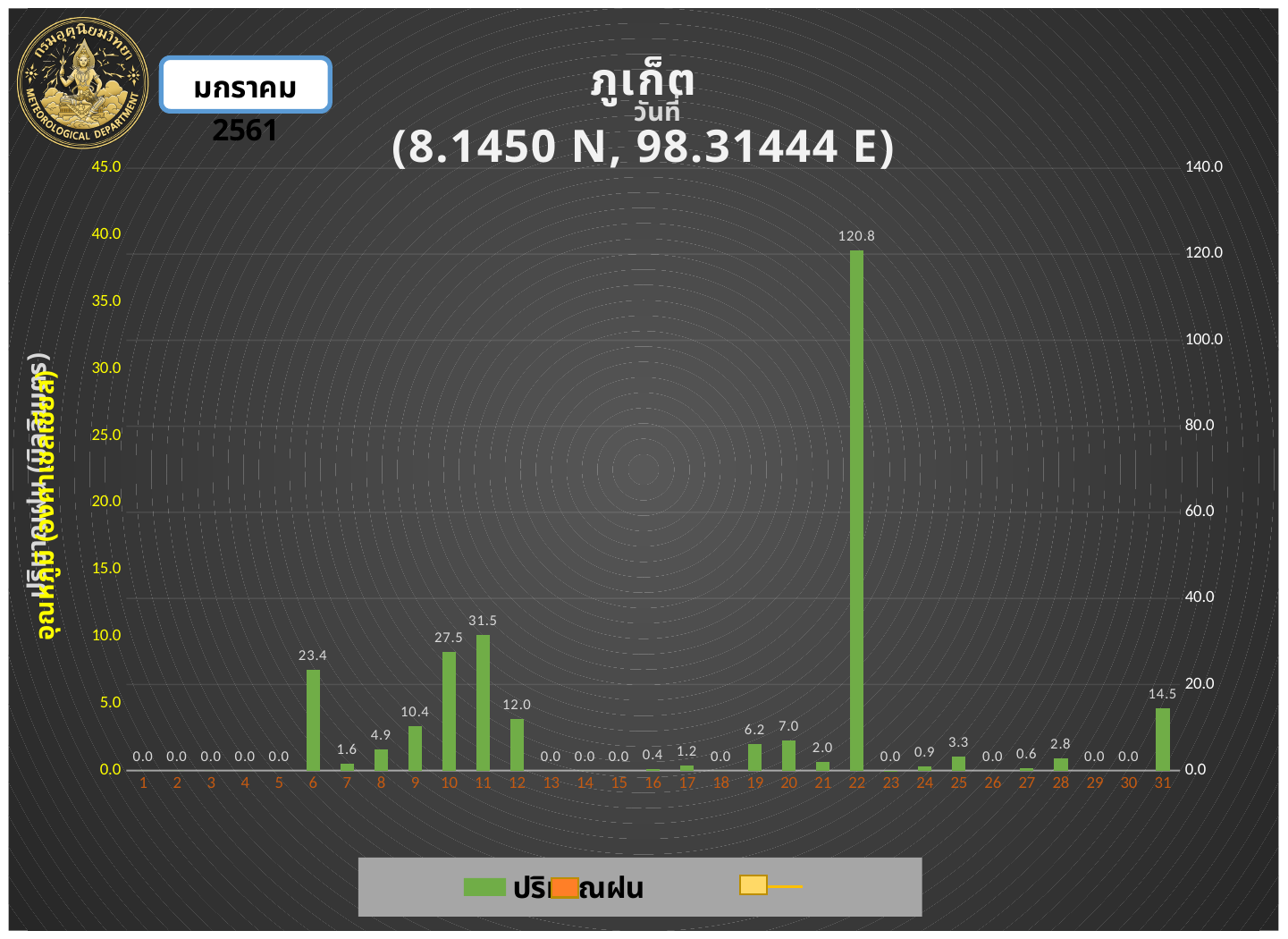
What is the value for day 31? 14.5 How many days are shown on the x axis? 31 What is the difference between the values for day 22 and day 31? 106.3 Is the value for day 22 greater or less than 100.0 on the right axis? greater Which is larger, the value for day 9 or the value for day 12? day 12 What is the value for day 11? 31.5 What is the difference between the values for day 11 and day 10? 4.0 What is the value for day 22? 120.8 What coordinates are shown in the chart title? 8.1450 N, 98.31444 E Which day has the highest value? 22 What kind of chart is this? bar chart What is the value for day 6? 23.4